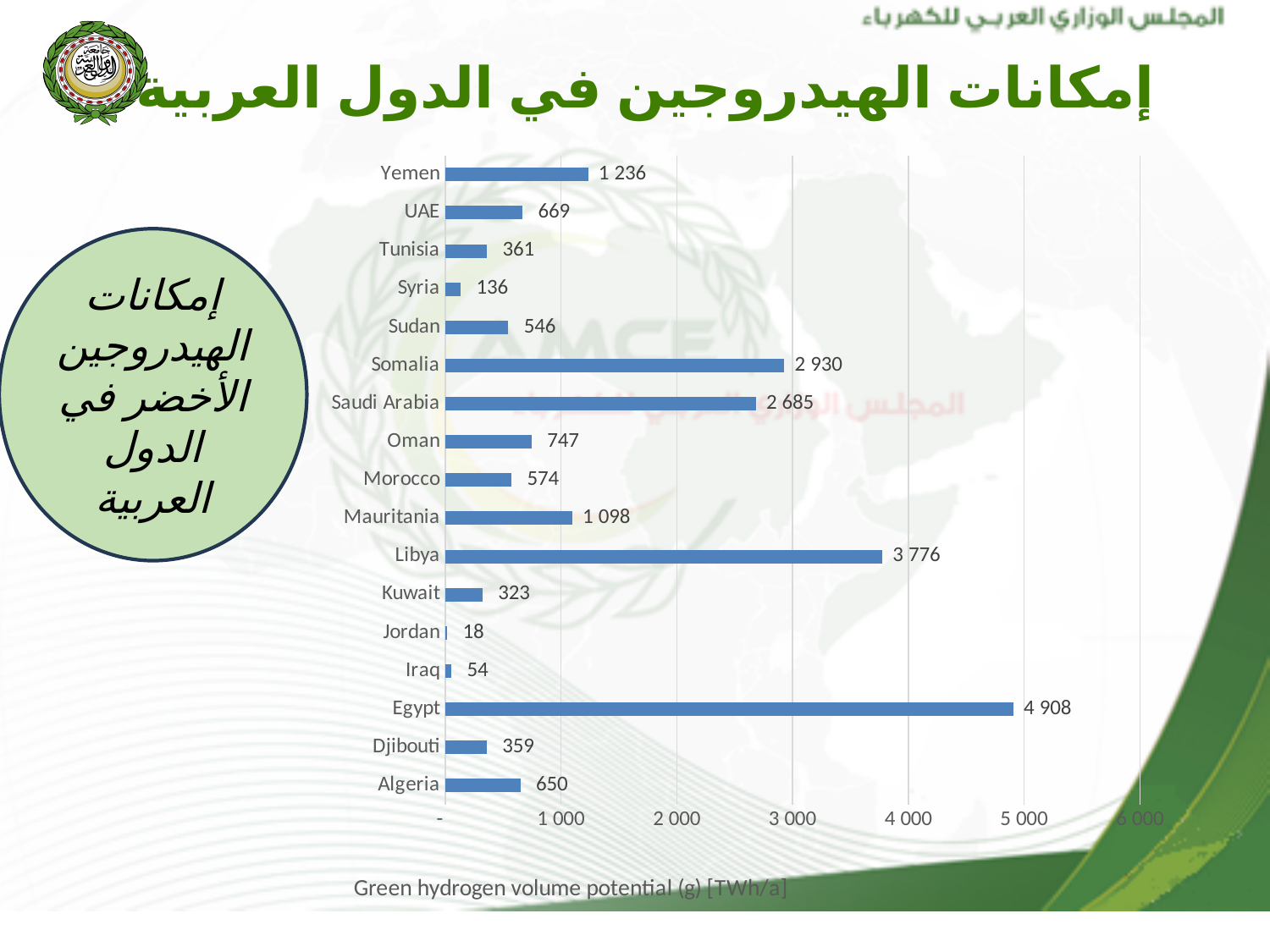
What value is shown for Jordan? 18 What value is shown for Somalia? 2 930 Which country has the lowest value in the chart? Jordan What is the green hydrogen volume potential value shown for Egypt? 4 908 What is the difference between the values for Somalia and Saudi Arabia? 245 How many countries are shown in the chart? 17 Which country has the highest value in the chart? Egypt What value is shown for Mauritania? 1 098 What is the difference between the values for Egypt and Libya? 1 132 Which has a larger value, Oman or UAE? Oman What kind of chart is shown on the slide? bar chart Is the value for Libya greater or less than 3 000? greater